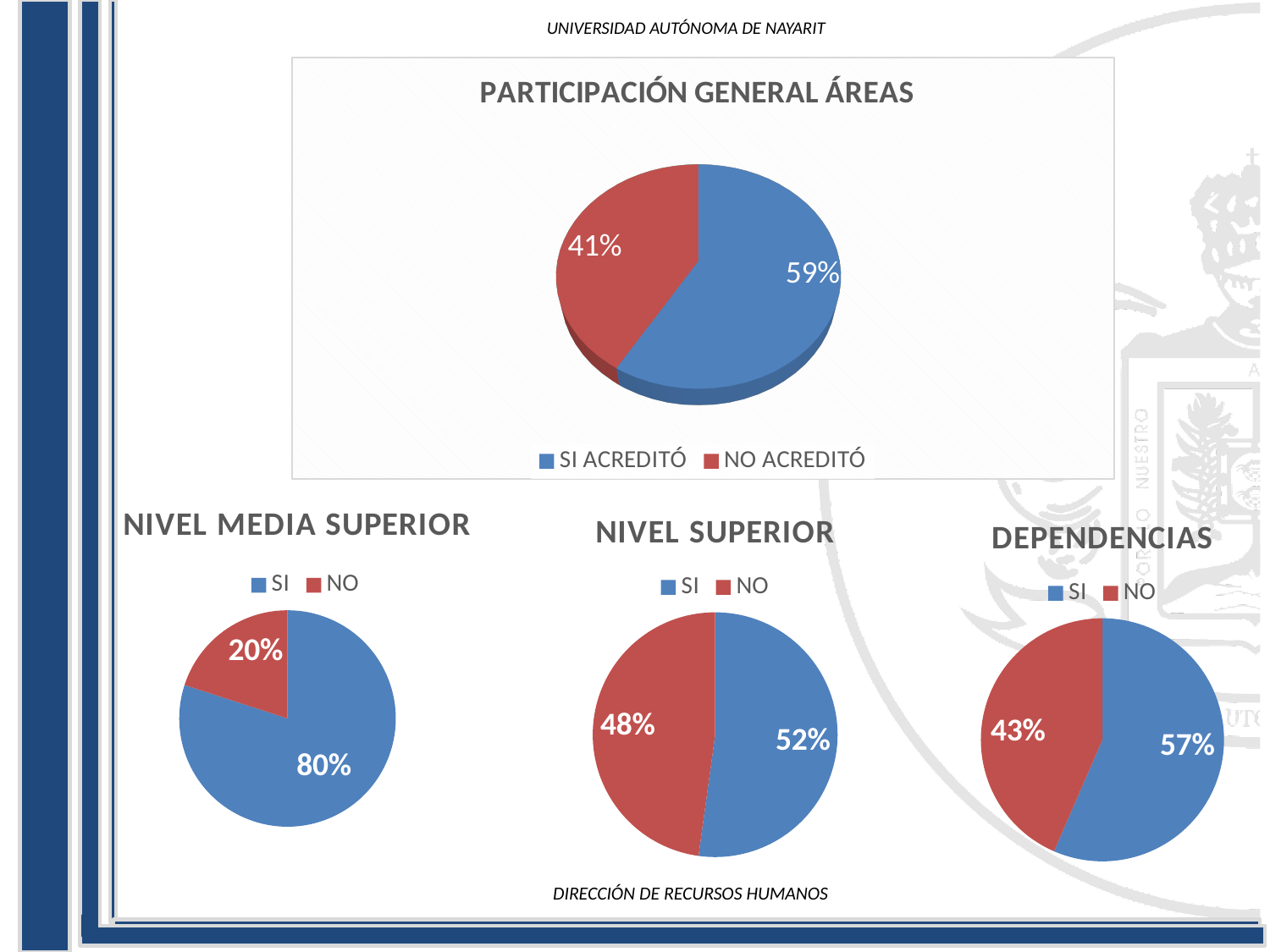
How many pie charts are shown on the slide? 4 In the 'PARTICIPACIÓN GENERAL ÁREAS' chart, what percentage is shown for SI ACREDITÓ? 59% In the 'NIVEL SUPERIOR' chart, which slice is larger, SI or NO? SI In the 'DEPENDENCIAS' chart, what is the difference between the SI and NO percentages? 14% In the 'NIVEL SUPERIOR' chart, what percentage is shown for NO? 48% What kind of chart is 'PARTICIPACIÓN GENERAL ÁREAS'? Pie chart In the 'DEPENDENCIAS' chart, what percentage is shown for SI? 57% In the 'PARTICIPACIÓN GENERAL ÁREAS' chart, what percentage is shown for NO ACREDITÓ? 41% In the 'NIVEL MEDIA SUPERIOR' chart, what is the difference between the SI and NO percentages? 60% In the 'NIVEL MEDIA SUPERIOR' chart, what percentage is shown for NO? 20% In the 'NIVEL MEDIA SUPERIOR' chart, what percentage is shown for SI? 80% How many entries does the legend of the 'PARTICIPACIÓN GENERAL ÁREAS' chart list? 2